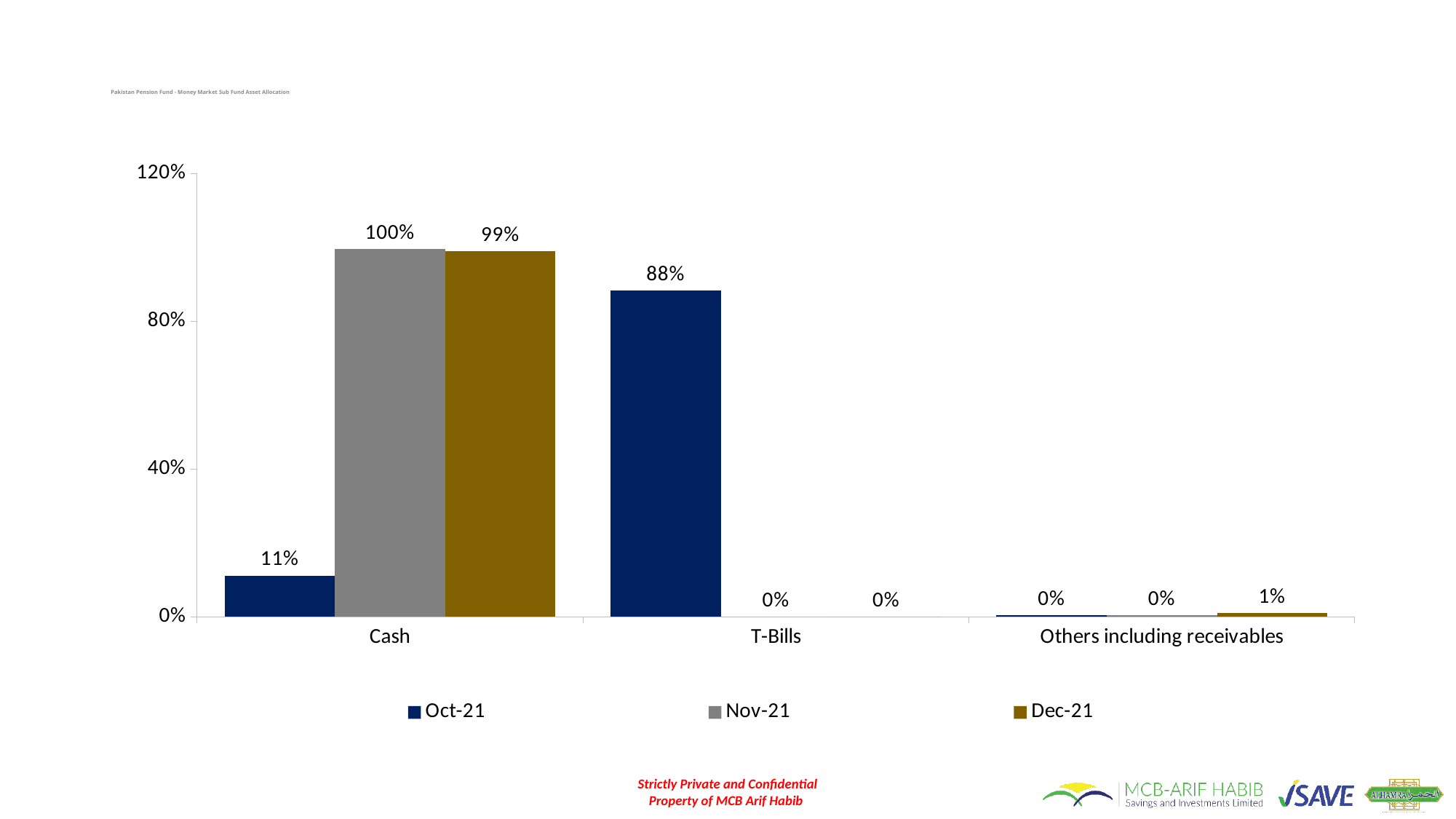
What is the difference between the Nov-21 and Oct-21 values for Cash? 89% Which category has the highest value for Oct-21? T-Bills Which is larger for Cash: the Nov-21 value or the Dec-21 value? Nov-21 What is the Cash value for Nov-21? 100% Which colour represents Dec-21 in the legend? Gold/brown How many categories are shown on the x axis? 3 How many series does the legend list? 3 What is the T-Bills value for Oct-21? 88% Which category has the lowest value for Dec-21? T-Bills What is the value for Others including receivables in Dec-21? 1% What kind of chart is shown on the slide? Bar chart What is the Cash value for Oct-21? 11%